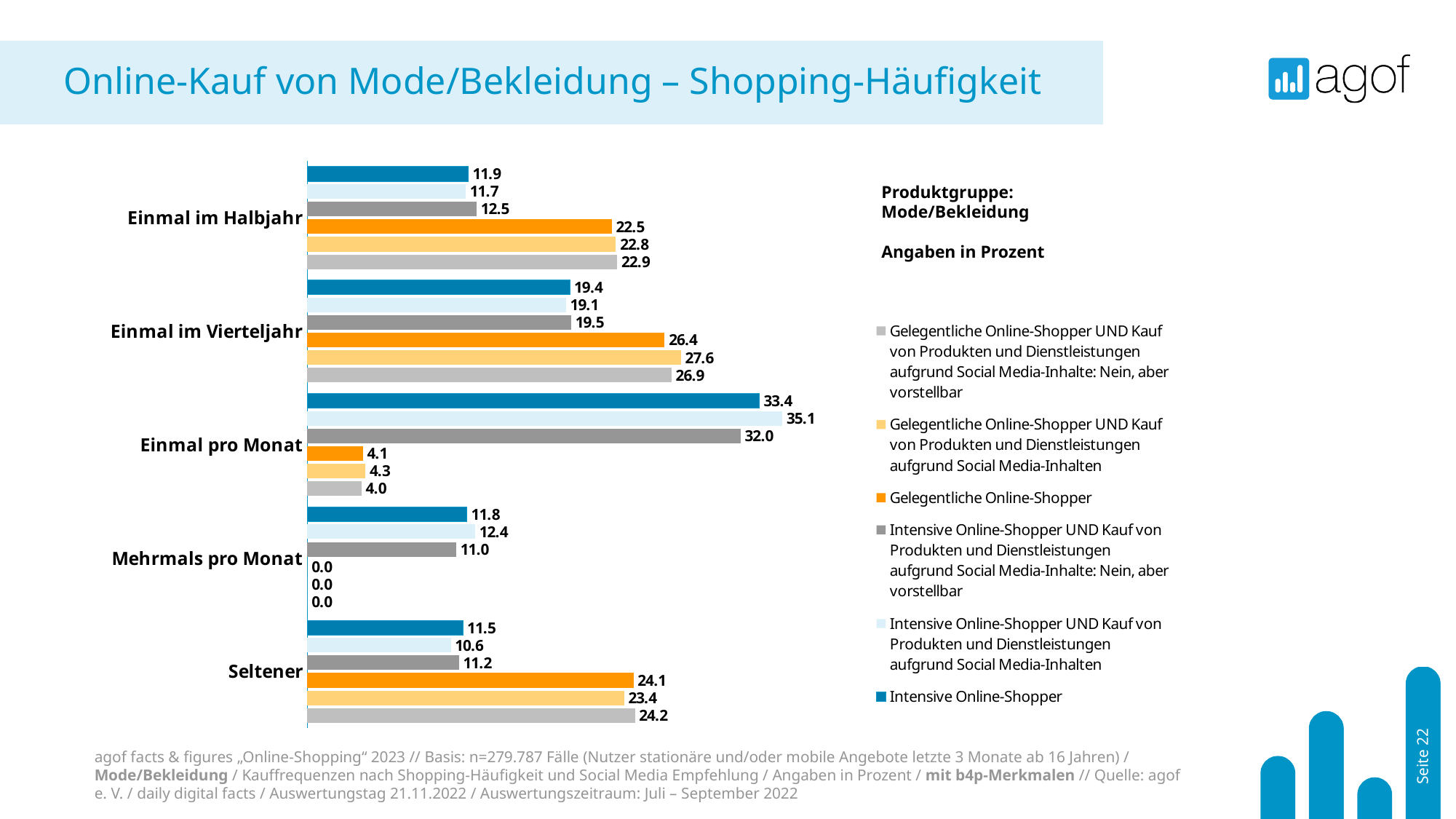
In the category Einmal pro Monat, which is larger: the value for Intensive Online-Shopper or the value for Gelegentliche Online-Shopper? Intensive Online-Shopper What is the value for Gelegentliche Online-Shopper in the category Seltener? 24.1 What is the highest value printed on the chart? 35.1 What kind of chart is shown on the slide? Bar chart What is the value for Intensive Online-Shopper in the category Mehrmals pro Monat? 11.8 What is the value for Intensive Online-Shopper in the category Einmal pro Monat? 33.4 How many series does the legend list? 6 What is the difference between the Gelegentliche Online-Shopper value and the Intensive Online-Shopper value in the category Einmal im Halbjahr? 10.6 How many categories are shown on the y axis of the chart? 5 Which category has the highest value for Intensive Online-Shopper? Einmal pro Monat Which category has the lowest value for Gelegentliche Online-Shopper? Mehrmals pro Monat What is the value for Gelegentliche Online-Shopper in the category Einmal im Vierteljahr? 26.4